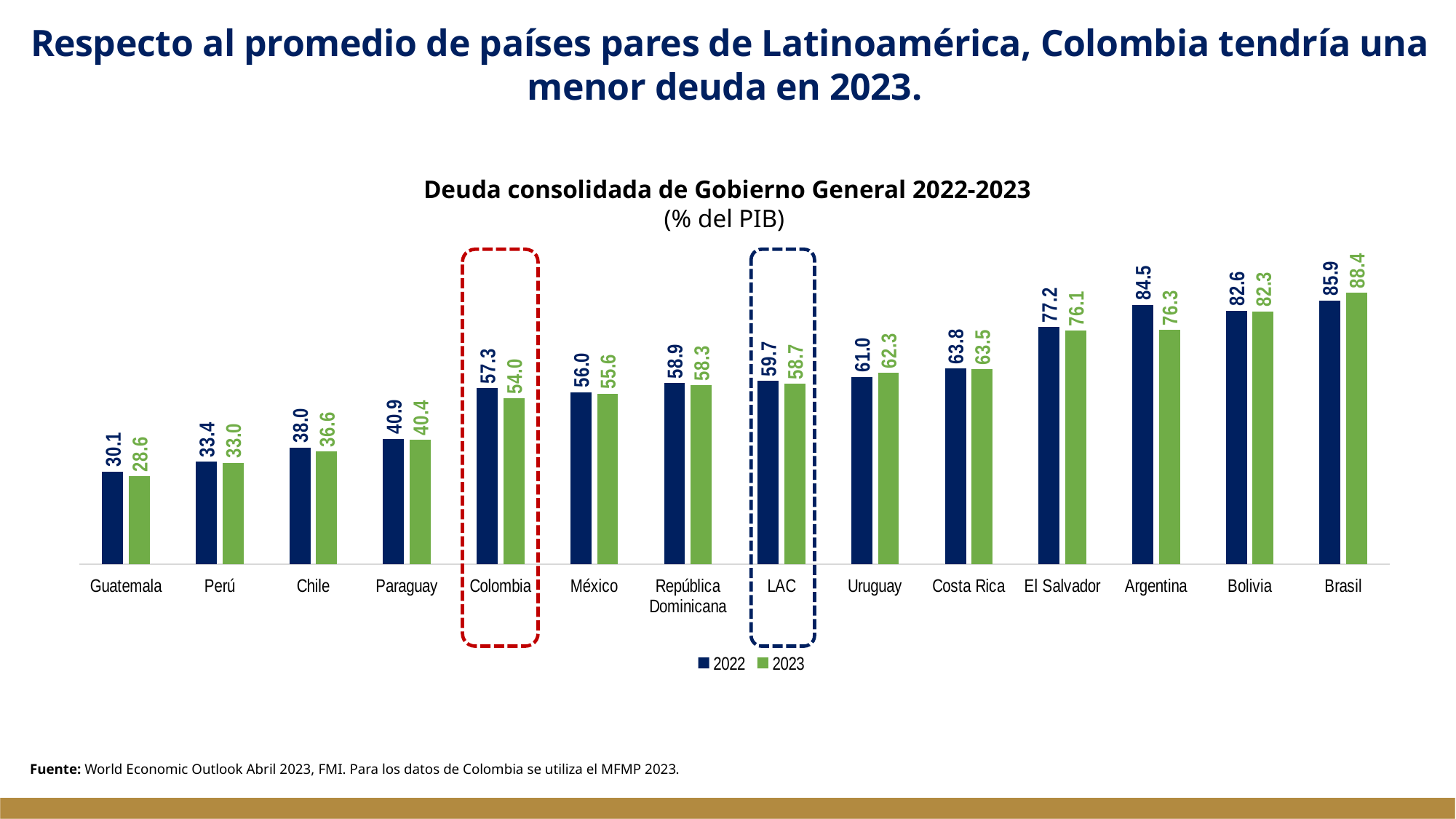
Which category has the highest 2023 value? Brasil How many categories are shown on the x axis? 14 What is the title of the chart? Deuda consolidada de Gobierno General 2022-2023 (% del PIB) What kind of chart is shown? Bar chart What is the difference between the 2022 and 2023 values for Colombia? 3.3 Which is larger, the 2023 value for Colombia or the 2023 value for LAC? LAC What is the 2022 value for LAC? 59.7 Which country has the lowest 2022 value? Guatemala How many series does the legend list? 2 What is the 2023 value for Brasil? 88.4 What is the 2023 value for Colombia? 54.0 What is the difference between the 2022 values for Brasil and Guatemala? 55.8